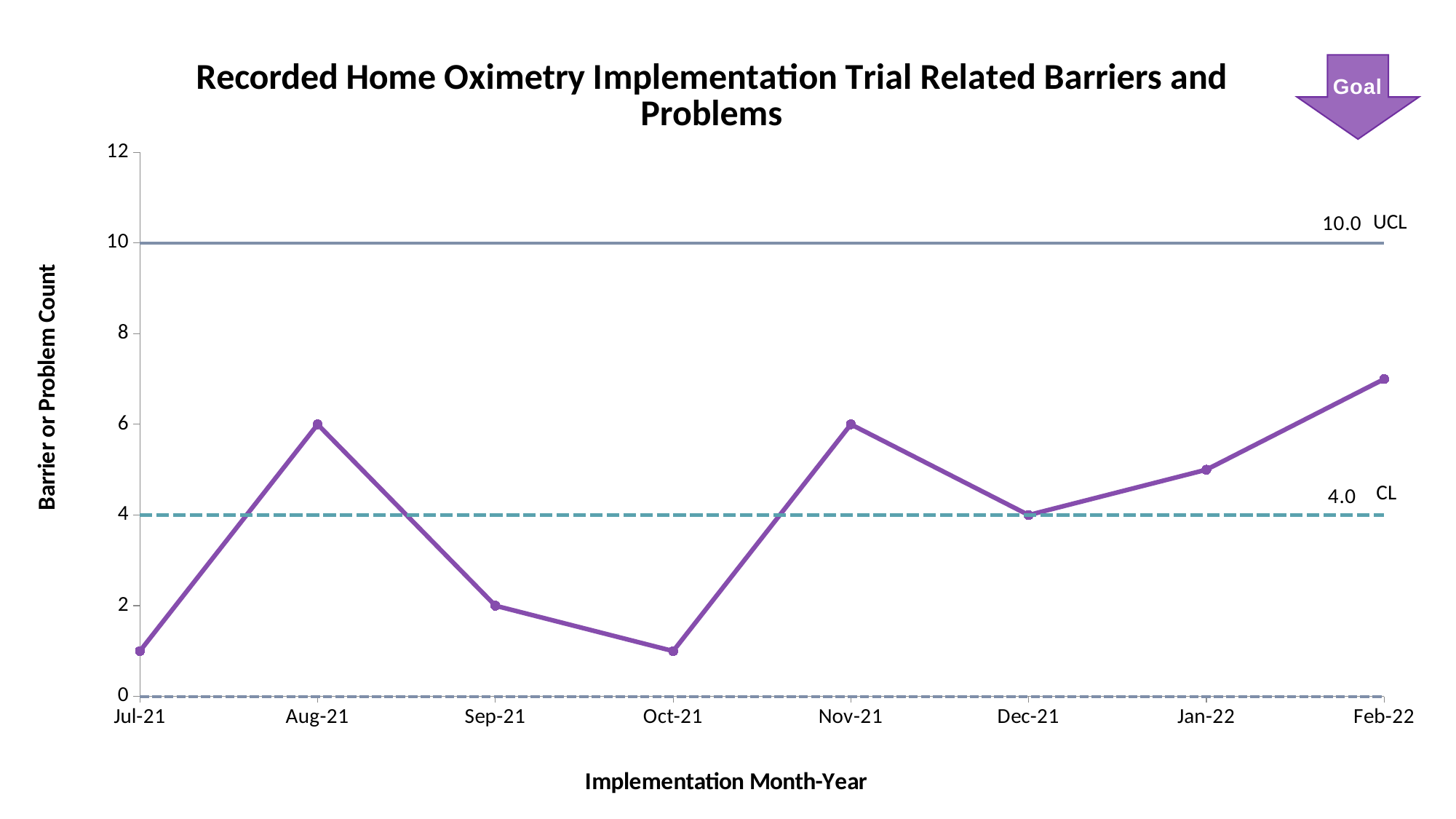
What is the barrier or problem count for Sep-21? 2 Which month has a higher barrier or problem count, Nov-21 or Sep-21? Nov-21 Which month has the highest barrier or problem count? Feb-22 What value is labelled for the UCL line? 10.0 What is the barrier or problem count for Dec-21? 4 What is the barrier or problem count for Aug-21? 6 Is the value for Jul-21 greater or less than 2? less Is the value for Feb-22 greater or less than 6? greater What is the difference between the counts for Nov-21 and Sep-21? 4 How many monthly data points are plotted on the line? 8 What value is labelled for the CL line? 4.0 What kind of chart is shown on the slide? line chart